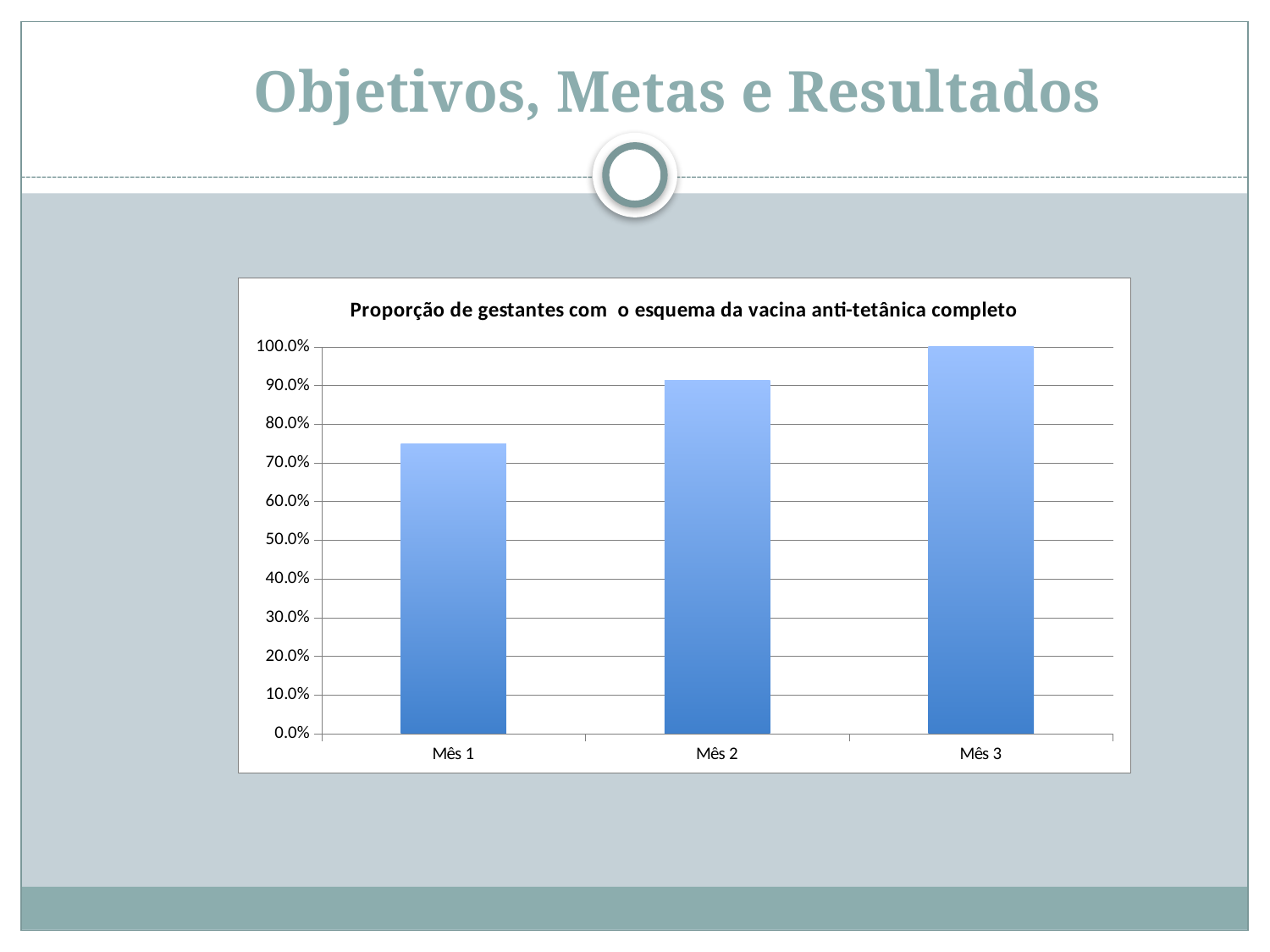
Which is larger, the value for Mês 1 or the value for Mês 2? Mês 2 How many categories are plotted on the x axis? 3 What type of chart is shown on the slide? bar chart Is the value for Mês 2 greater or less than 100.0%? less Is the value for Mês 1 greater or less than 80.0%? less What is the title of the chart? Proporção de gestantes com o esquema da vacina anti-tetânica completo Is the value for Mês 1 greater or less than 70.0%? greater Do the values rise or fall from Mês 1 to Mês 3? rise Which category has the lowest value? Mês 1 What is the value for Mês 3? 100.0% Which category has the highest value? Mês 3